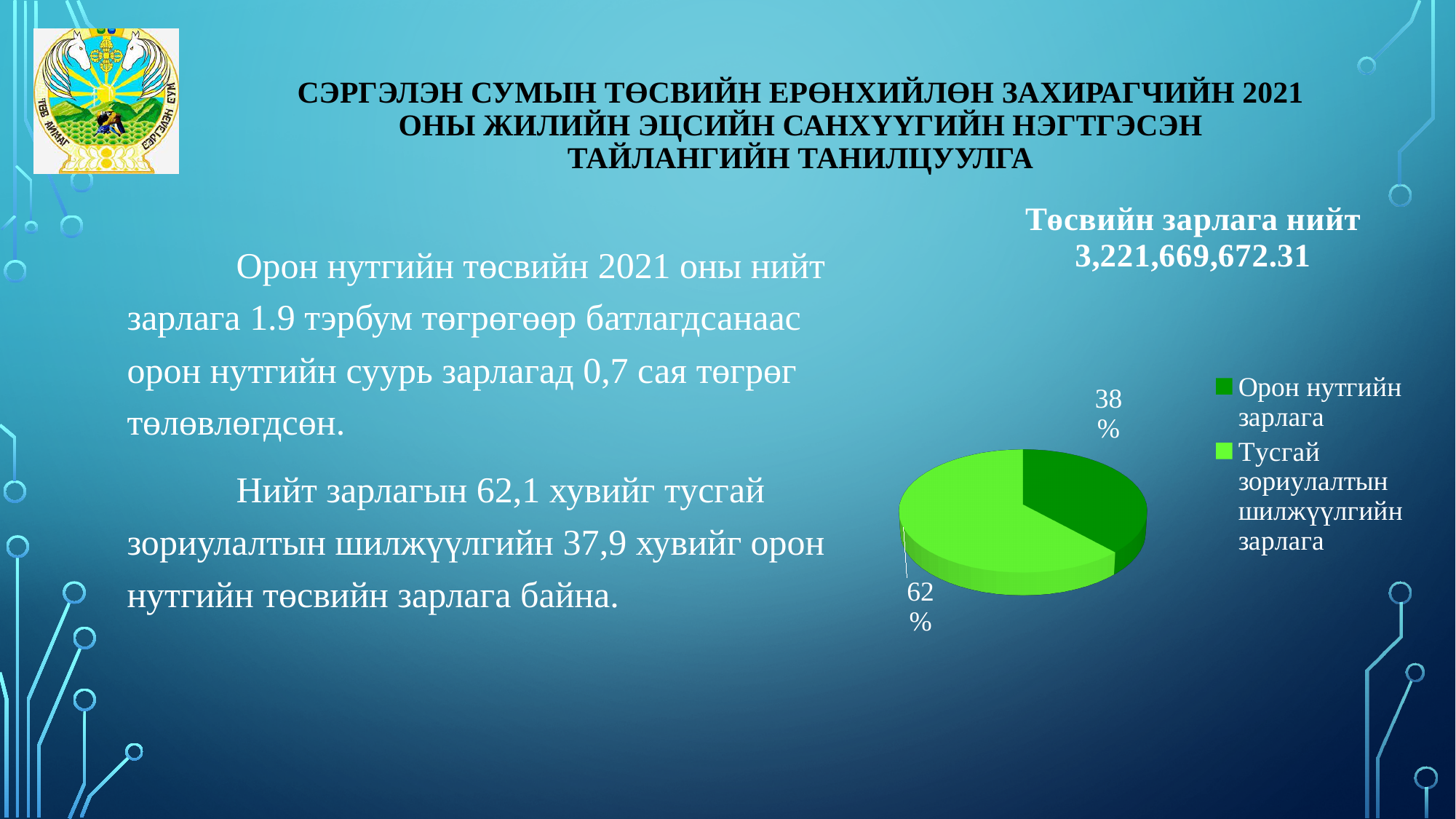
What kind of chart is shown on the slide? pie chart What share of the pie does "Орон нутгийн зарлага" represent? 38% Which is larger: the "Орон нутгийн зарлага" slice or the "Тусгай зориулалтын шилжүүлгийн зарлага" slice? Тусгай зориулалтын шилжүүлгийн зарлага What share of the pie does "Тусгай зориулалтын шилжүүлгийн зарлага" represent? 62% What is the difference in percentage points between the "Тусгай зориулалтын шилжүүлгийн зарлага" slice and the "Орон нутгийн зарлага" slice? 24 Which legend entry is shown in dark green in the pie chart? Орон нутгийн зарлага What is the title of the pie chart? Төсвийн зарлага нийт 3,221,669,672.31 Which slice of the pie chart is the largest? Тусгай зориулалтын шилжүүлгийн зарлага Which slice of the pie chart is the smallest? Орон нутгийн зарлага How many entries does the legend of the pie chart list? 2 How many slices does the pie chart have? 2